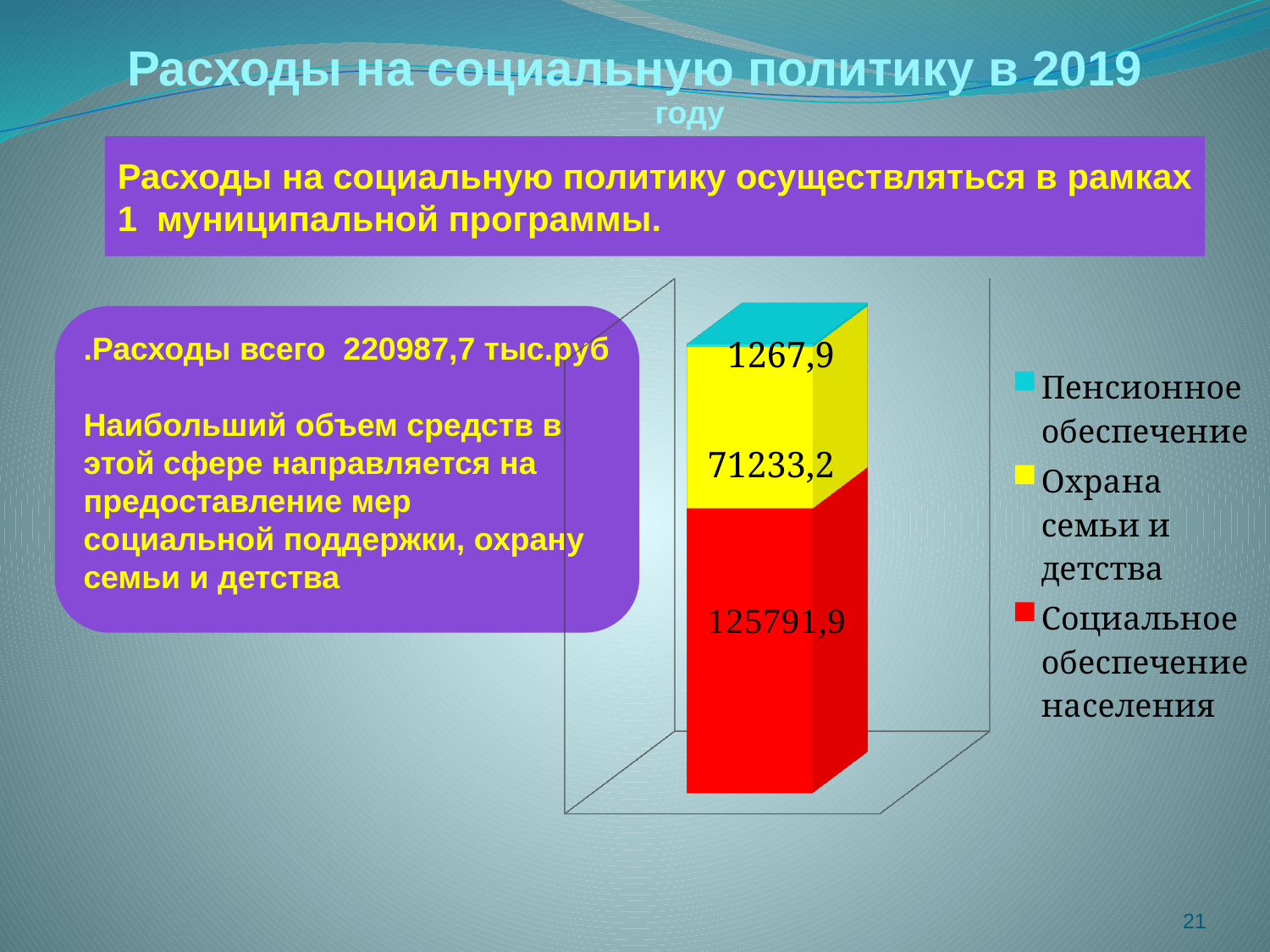
What is the value for Социальное обеспечение населения in the stacked bar? 125791,9 What is the value for Охрана семьи и детства in the stacked bar? 71233,2 What is the total of the stacked bar? 198293,0 What is the difference between the values for Социальное обеспечение населения and Охрана семьи и детства? 54558,7 How many series does the legend list? 3 What colour represents Социальное обеспечение населения in the chart? Red What is the value for Пенсионное обеспечение in the stacked bar? 1267,9 What kind of chart is shown on the slide? Stacked bar chart Which series has the largest value in the stacked bar? Социальное обеспечение населения What is the difference between the values for Охрана семьи и детства and Пенсионное обеспечение? 69965,3 Which is larger: the value for Охрана семьи и детства or the value for Пенсионное обеспечение? Охрана семьи и детства Which series has the smallest value in the stacked bar? Пенсионное обеспечение